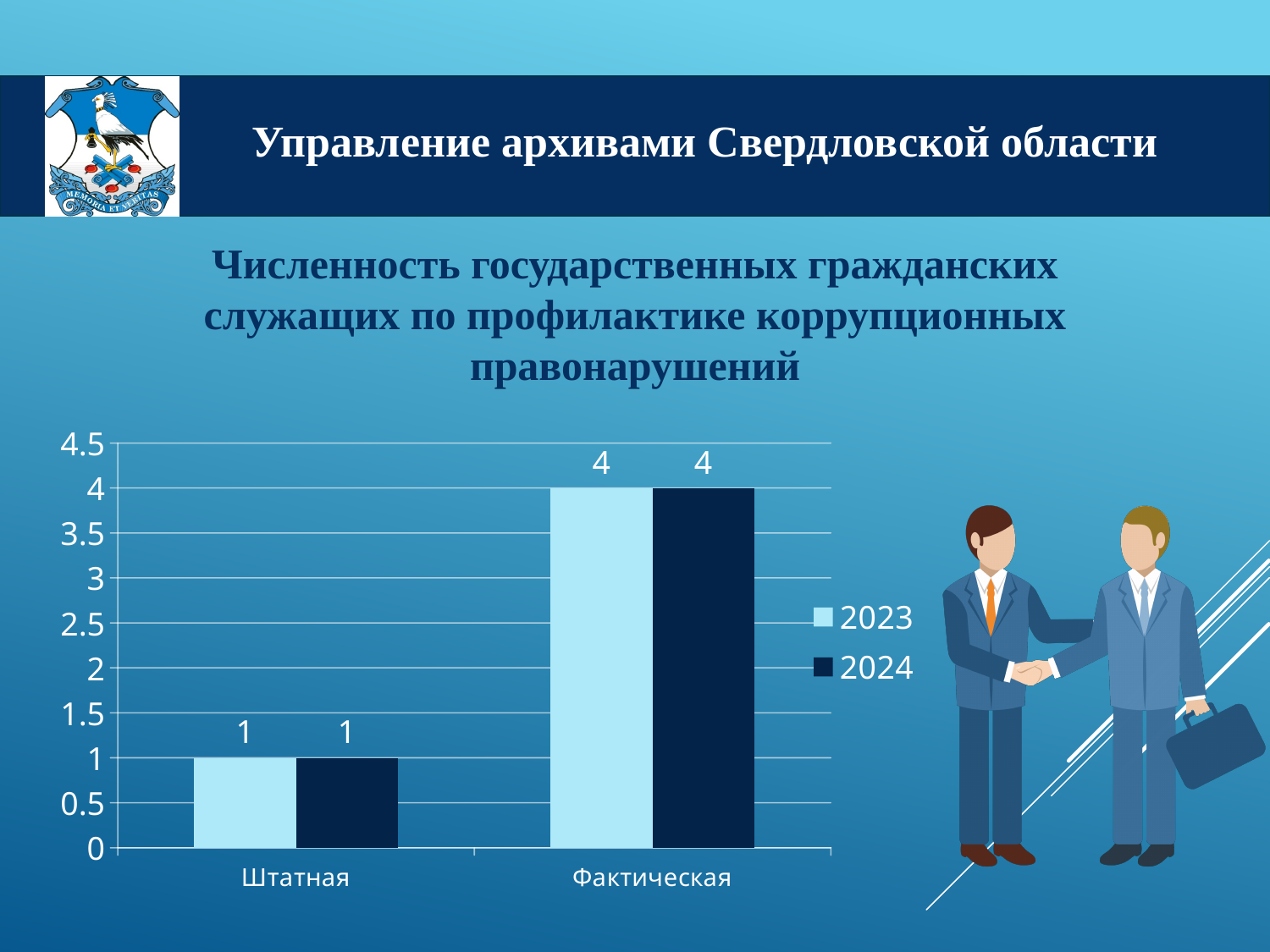
What kind of chart is shown on the slide? bar chart What is the value for Штатная in 2023? 1 How many series does the legend list? 2 What is the difference between the 2023 values for Фактическая and Штатная? 3 How many categories are shown on the x axis? 2 Is the value for Фактическая in 2023 greater or less than 3? greater Which is larger: the 2024 value for Фактическая or the 2024 value for Штатная? Фактическая Which category has the lowest value in 2024? Штатная What is the value for Фактическая in 2024? 4 Which category has the highest value in 2023? Фактическая What is the value for Штатная in 2024? 1 Which series is shown in dark navy in the legend? 2024